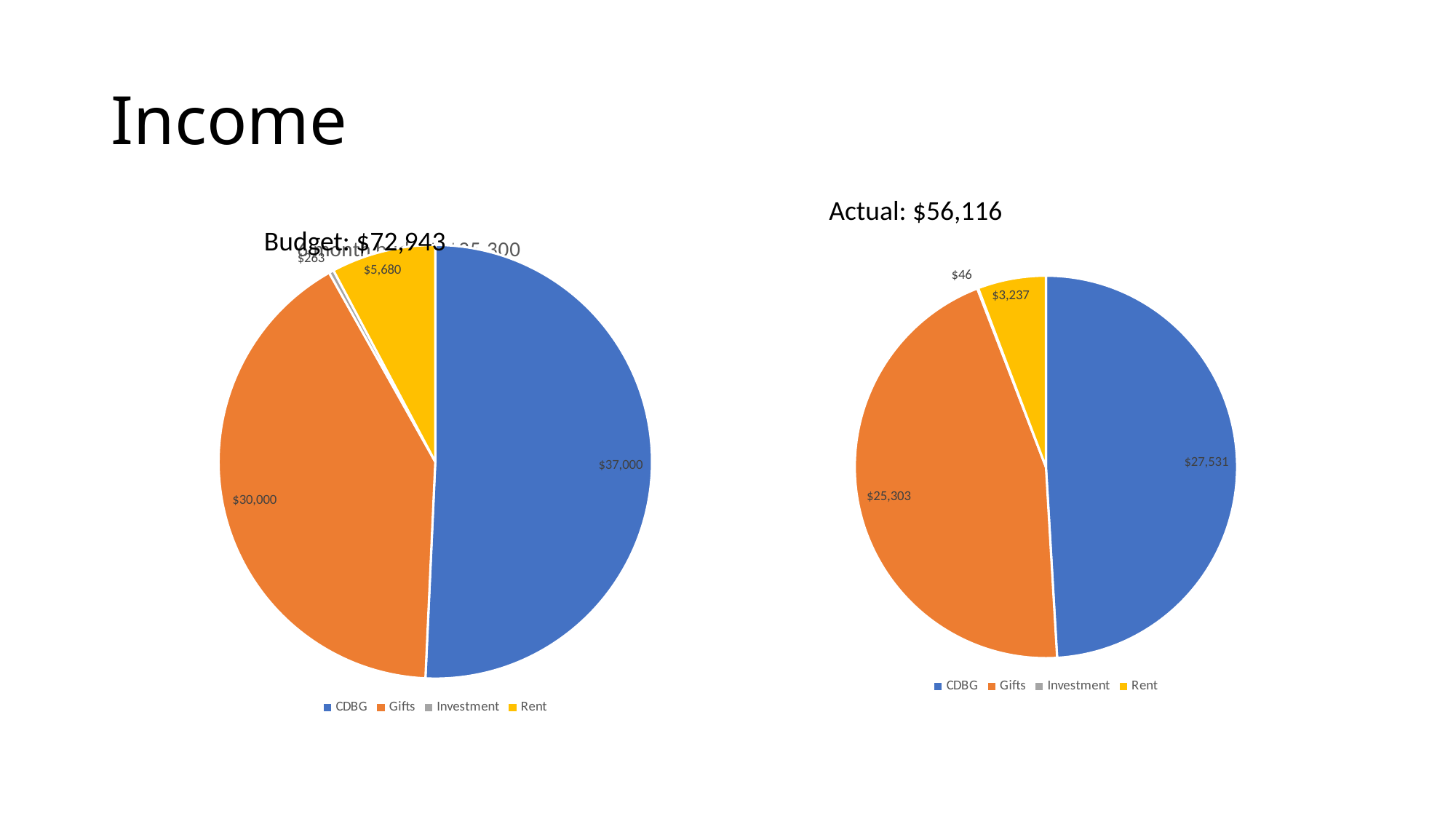
In the Actual chart on the right, which category has the smallest slice? Investment In the Actual chart on the right, what is the difference between CDBG and Gifts? $2,228 In the Actual chart on the right, which category has the largest slice? CDBG In the Actual chart on the right, what is the value for Investment? $46 In the Budget chart on the left, what is the value for Gifts? $30,000 What type of chart is used for the Budget chart on the left? Pie chart Is the Rent value larger in the Budget chart or the Actual chart? Budget chart How many categories does the legend of the Actual chart on the right list? 4 In the Budget chart on the left, what is the difference between CDBG and Gifts? $7,000 In the Actual chart on the right, what is the value for CDBG? $27,531 In the Budget chart on the left, what is the value for CDBG? $37,000 In the Budget chart on the left, what is the value for Rent? $5,680